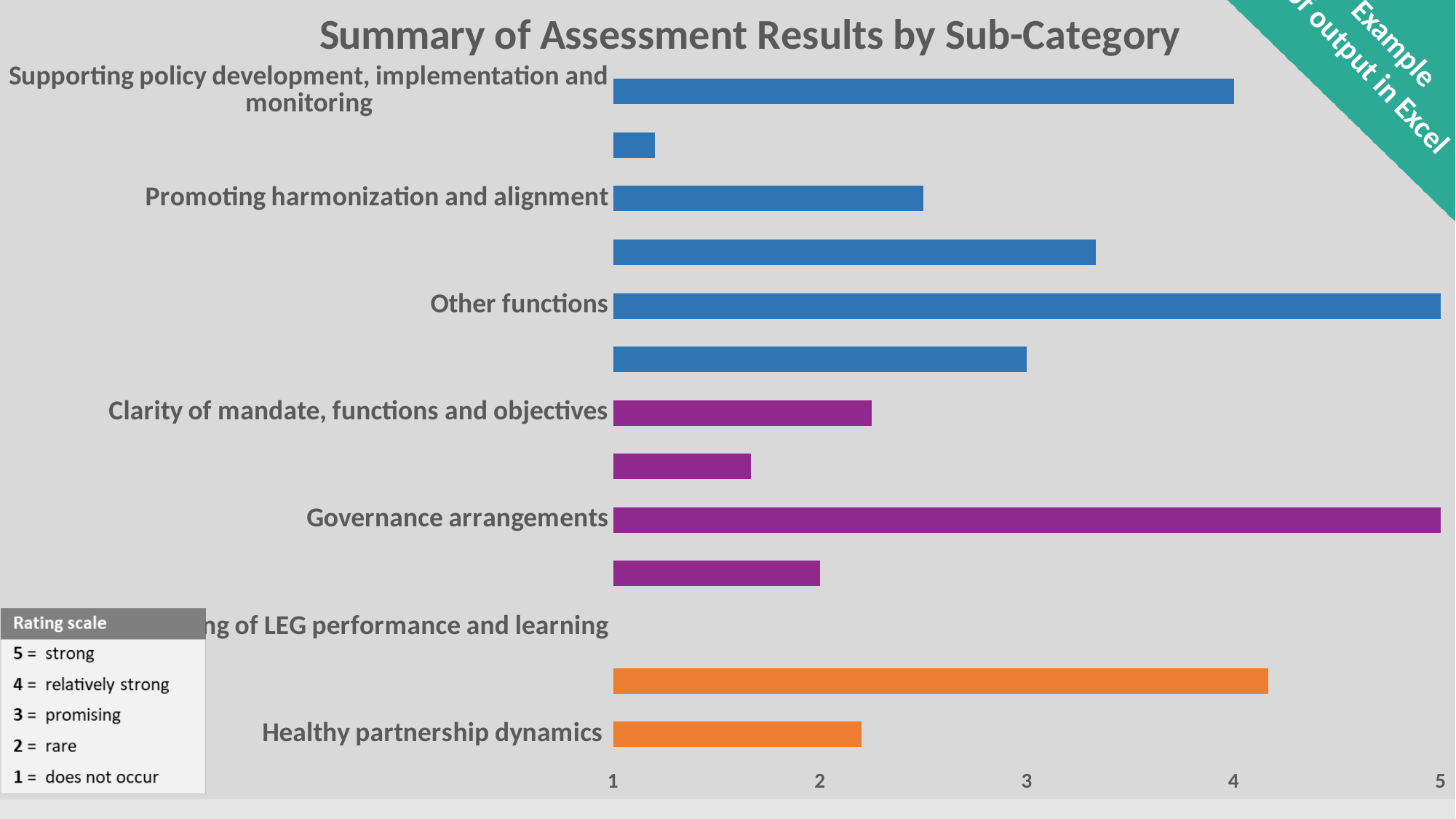
Is the value for Promoting harmonization and alignment greater or less than 3? less Which has the larger value, Other functions or Clarity of mandate, functions and objectives? Other functions What is the title of the chart? Summary of Assessment Results by Sub-Category What is the value for Governance arrangements? 5 Is the value for Healthy partnership dynamics greater or less than 3? less What is the value for Other functions? 5 What is the difference between the value for Other functions and the value for Supporting policy development, implementation and monitoring? 1 What kind of chart is shown on the slide? bar chart According to the rating scale on the slide, what does a rating of 3 mean? promising Is the value for Clarity of mandate, functions and objectives greater or less than 2? greater Which has the larger value, Supporting policy development, implementation and monitoring or Promoting harmonization and alignment? Supporting policy development, implementation and monitoring What is the value for Supporting policy development, implementation and monitoring? 4